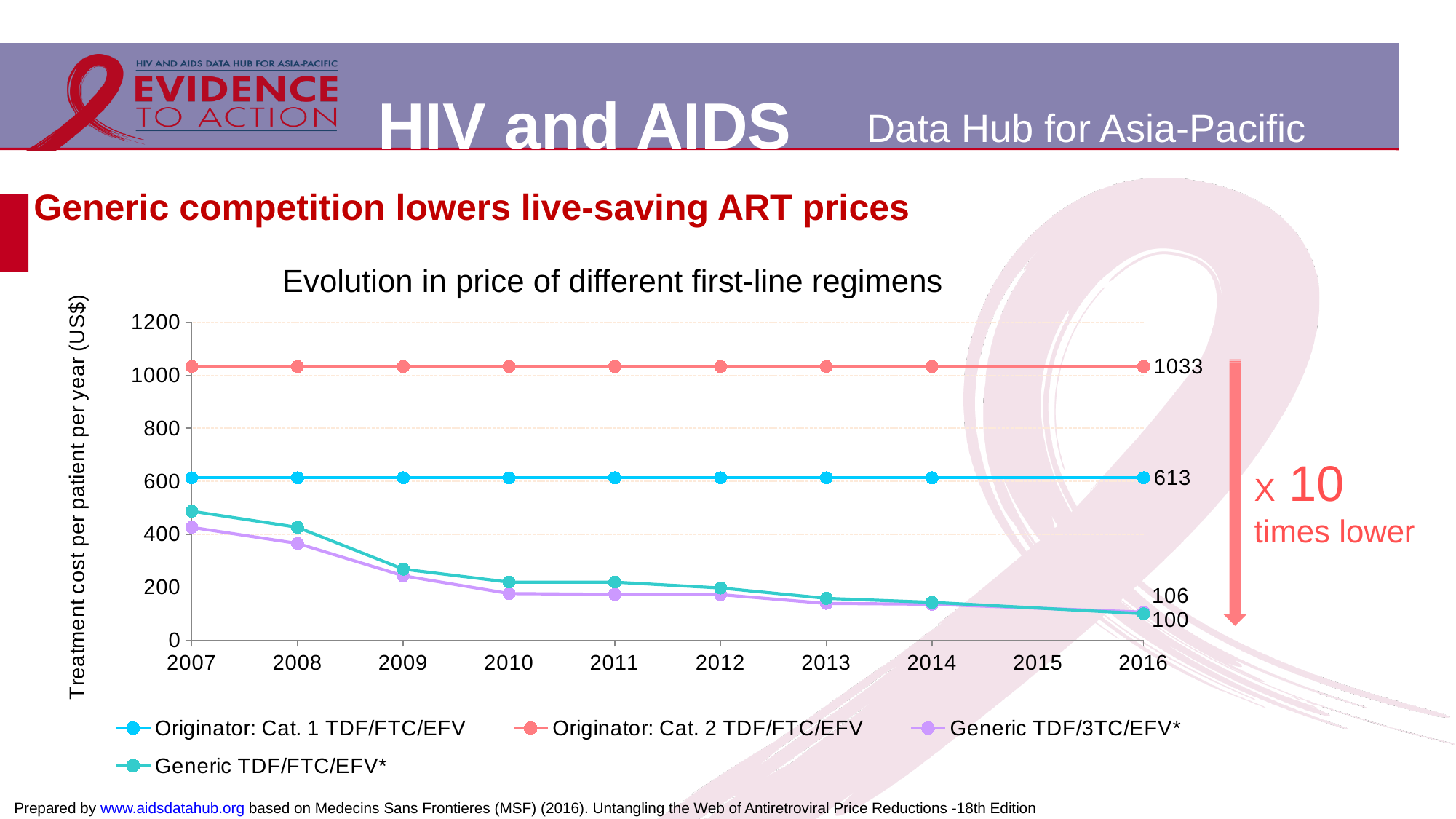
Is the value for Generic TDF/FTC/EFV* in 2007 greater or less than 400? greater What is the 2016 value for Originator: Cat. 2 TDF/FTC/EFV? 1033 What is the 2016 value for Originator: Cat. 1 TDF/FTC/EFV? 613 What is the 2016 value for Generic TDF/3TC/EFV*? 106 How many series does the legend list? 4 How many years are labelled on the x axis? 10 What is the 2016 value for Generic TDF/FTC/EFV*? 100 What is the difference between the 2016 values of Originator: Cat. 2 TDF/FTC/EFV and Originator: Cat. 1 TDF/FTC/EFV? 420 Which series has the highest value in 2016? Originator: Cat. 2 TDF/FTC/EFV Does the value for Generic TDF/3TC/EFV* rise or fall from 2007 to 2016? Fall What is the title of the chart? Evolution in price of different first-line regimens What kind of chart is shown on the slide? Line chart